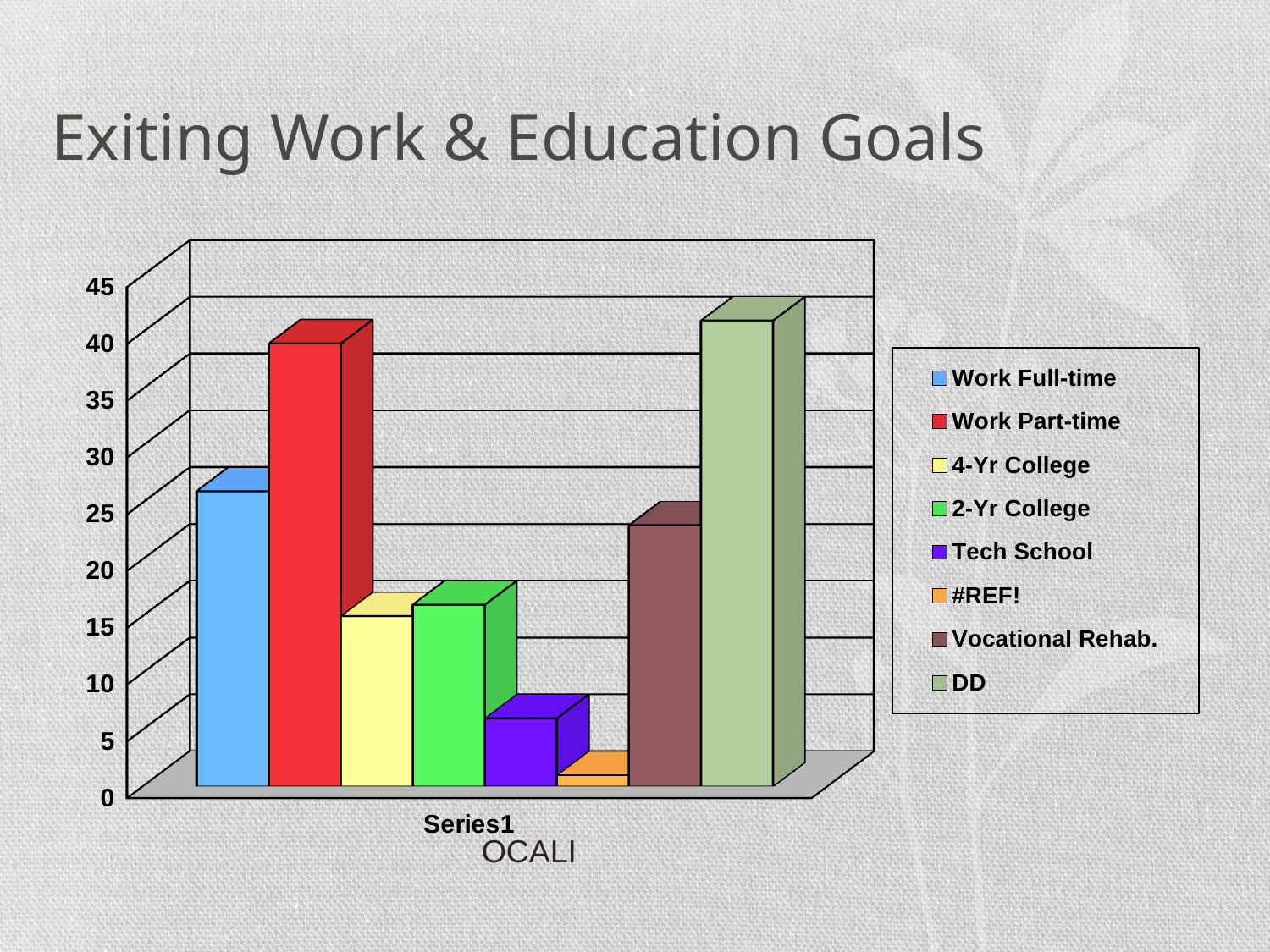
Is the value for Work Part-time greater or less than 35? greater Which series has the lowest value? #REF! How many series does the legend list? 8 Which series has the highest value? DD Is the value for DD greater or less than 35? greater What kind of chart is shown on the slide? Bar chart Is the value for Vocational Rehab. greater or less than 20? greater What is the title of the slide containing the chart? Exiting Work & Education Goals Which is larger, Work Part-time or Work Full-time? Work Part-time Which is larger, Vocational Rehab. or Tech School? Vocational Rehab.